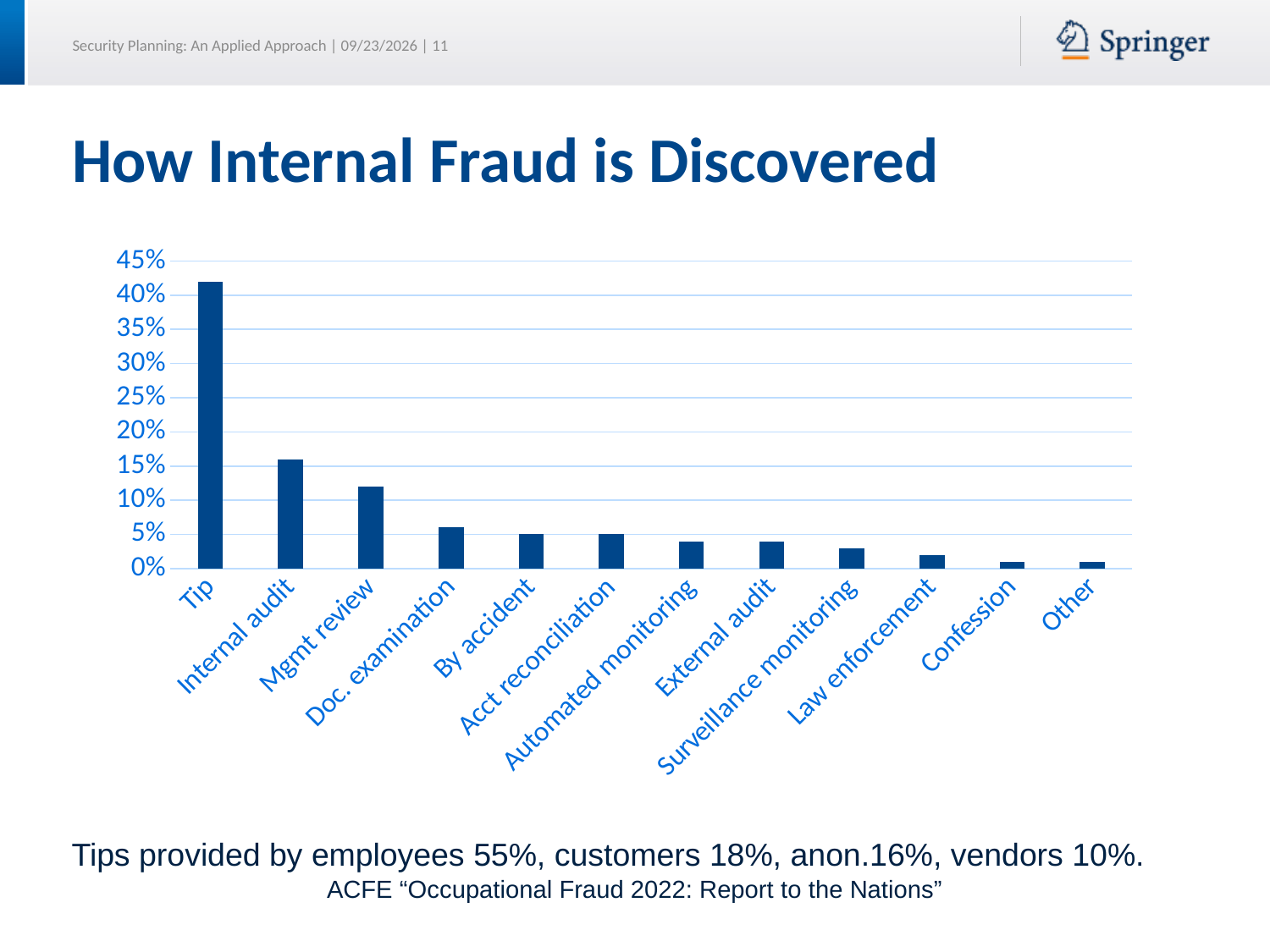
Do the values generally rise or fall moving from left to right along the x axis? fall What kind of chart is shown on the slide? bar chart What is the title of the chart? How Internal Fraud is Discovered Is the value for Mgmt review greater or less than 10%? greater Which is larger, the value for Internal audit or the value for Mgmt review? Internal audit Which is larger, the value for Tip or the value for External audit? Tip Is the value for Law enforcement greater or less than 5%? less Which category has the highest value? Tip Is the value for Internal audit greater or less than 10%? greater How many categories are plotted on the x axis? 12